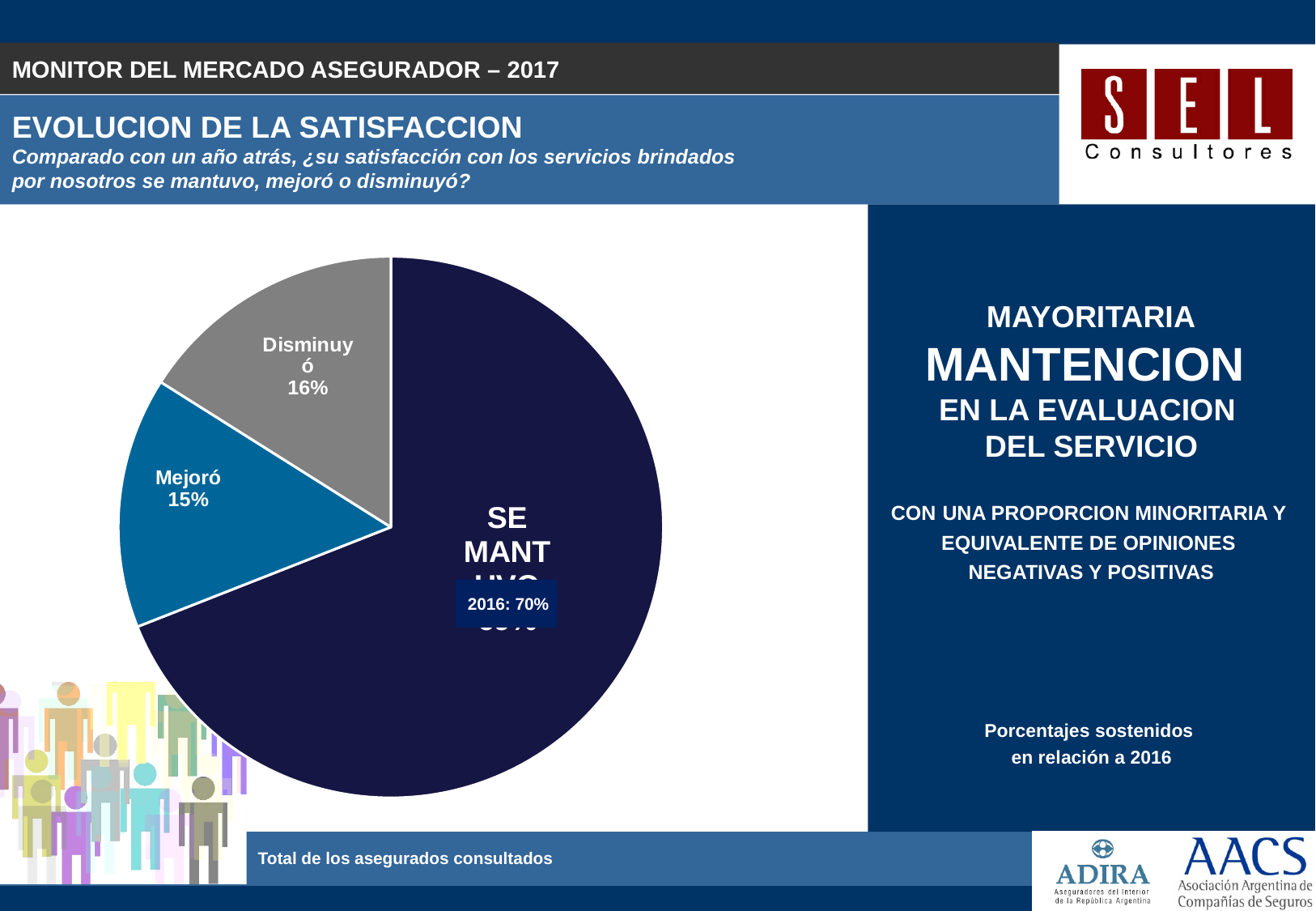
What is the difference between the 'Disminuyó' share and the 'Mejoró' share? 1% What colour is the 'Disminuyó' slice? Grey Which category has the largest slice of the pie chart? Se mantuvo What colour is the 'Mejoró' slice? Blue What kind of chart is shown on the slide? Pie chart What percentage of respondents said their satisfaction 'Disminuyó'? 16% What was the 2016 value shown for 'Se mantuvo'? 70% What percentage of respondents said their satisfaction 'Mejoró'? 15% How many slices does the pie chart have? 3 Which category has the smallest slice of the pie chart? Mejoró Which is larger, the share for 'Mejoró' or the share for 'Disminuyó'? Disminuyó